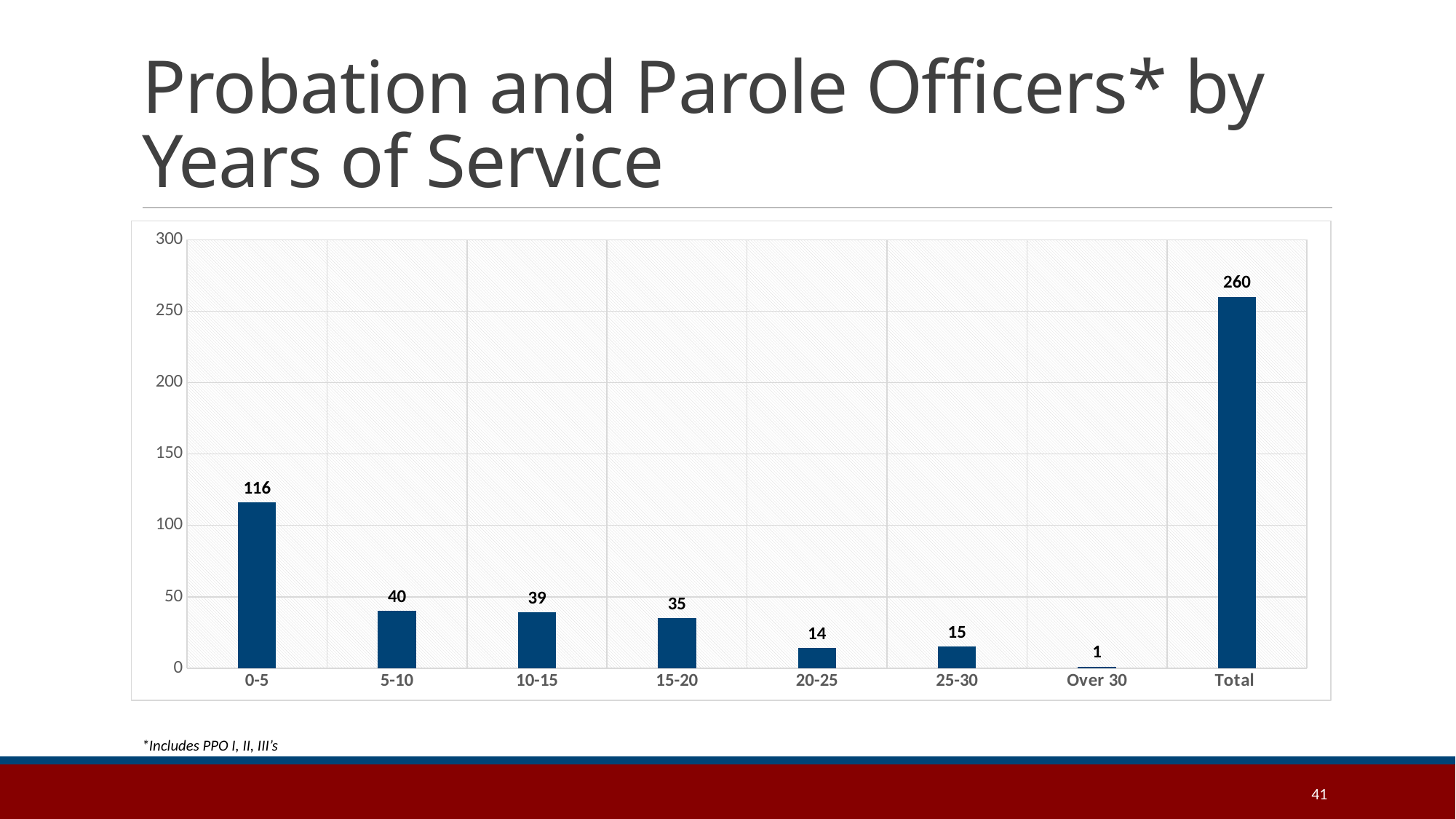
Is the value for 0-5 greater or less than 100? greater What is the value for the 0-5 years of service category? 116 Which category has the lowest value? Over 30 What kind of chart is shown on the slide? Bar chart Excluding the Total bar, which years-of-service category has the highest value? 0-5 What is the value for the Over 30 category? 1 How many bars are shown in the chart, including the Total bar? 8 Which is larger, the value for 15-20 or the value for 25-30? 15-20 What is the value for the 20-25 years of service category? 14 What is the title of the slide containing the chart? Probation and Parole Officers* by Years of Service What is the difference between the values for 0-5 and 5-10? 76 What is the value shown for the Total bar? 260